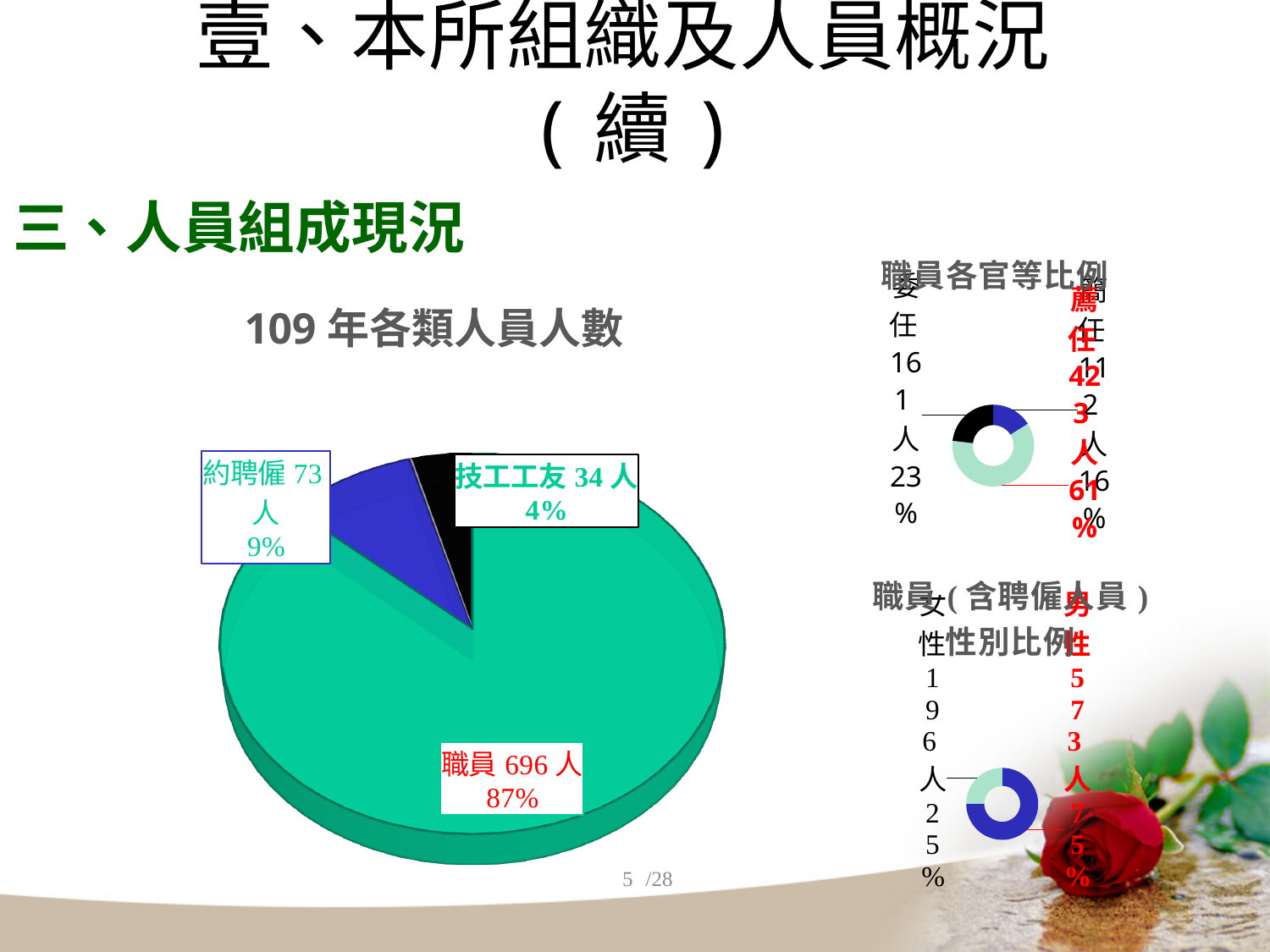
In the chart titled 109 年各類人員人數, how many categories are shown? 3 In the chart titled 109 年各類人員人數, what percentage share does 約聘僱 have? 9% In the chart titled 職員各官等比例, how many people are in the 委任 category? 161 人 What kind of chart is the one titled 109 年各類人員人數? pie chart In the chart titled 109 年各類人員人數, how many people are in the 職員 category? 696 人 In the chart titled 職員(含聘僱人員)性別比例, how many people are 女性? 196 人 In the chart titled 109 年各類人員人數, which category has the smallest share? 技工工友 In the chart titled 109 年各類人員人數, which category has the largest share? 職員 In the chart titled 109 年各類人員人數, how many more people are in 約聘僱 than in 技工工友? 39 人 In the chart titled 職員(含聘僱人員)性別比例, which is larger, 男性 or 女性? 男性 In the chart titled 109 年各類人員人數, how many people are in the 技工工友 category? 34 人 In the chart titled 職員(含聘僱人員)性別比例, what percentage share is 男性? 75%